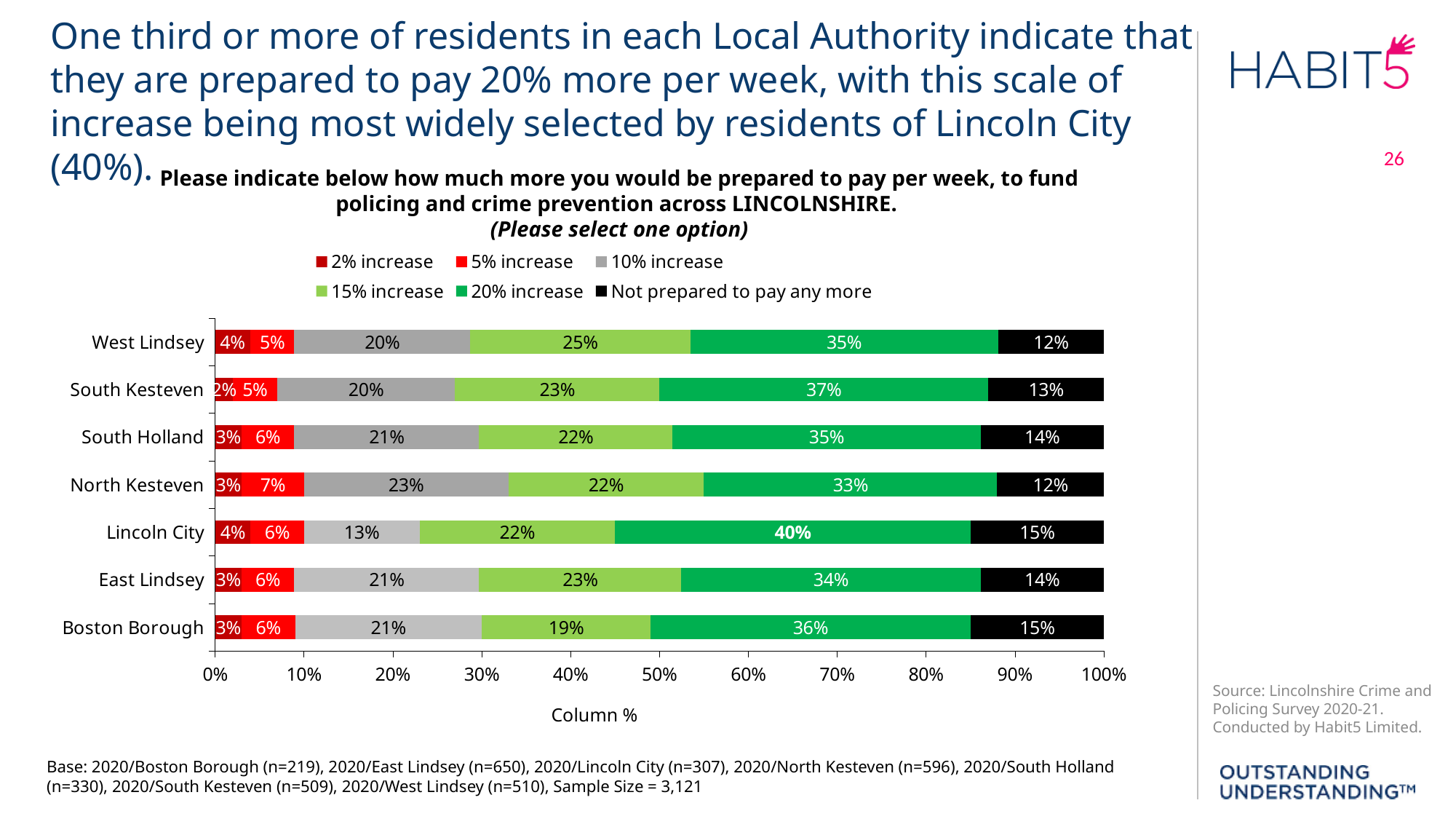
What percentage of West Lindsey residents selected a 20% increase? 35% What is the difference between the 20% increase share for Lincoln City and for North Kesteven? 7% What percentage of Boston Borough residents are not prepared to pay any more? 15% What is the label on the horizontal axis of the chart? Column % What percentage of Lincoln City residents selected a 10% increase? 13% How many series does the legend list? 6 What type of chart is shown on the slide? Stacked bar chart What percentage of North Kesteven residents selected a 5% increase? 7% How many Local Authorities are shown in the chart? 7 Which Local Authority has the lowest share of residents selecting a 20% increase? North Kesteven Which has a larger share of residents selecting a 15% increase: West Lindsey or Boston Borough? West Lindsey Which Local Authority has the highest share of residents selecting a 20% increase? Lincoln City